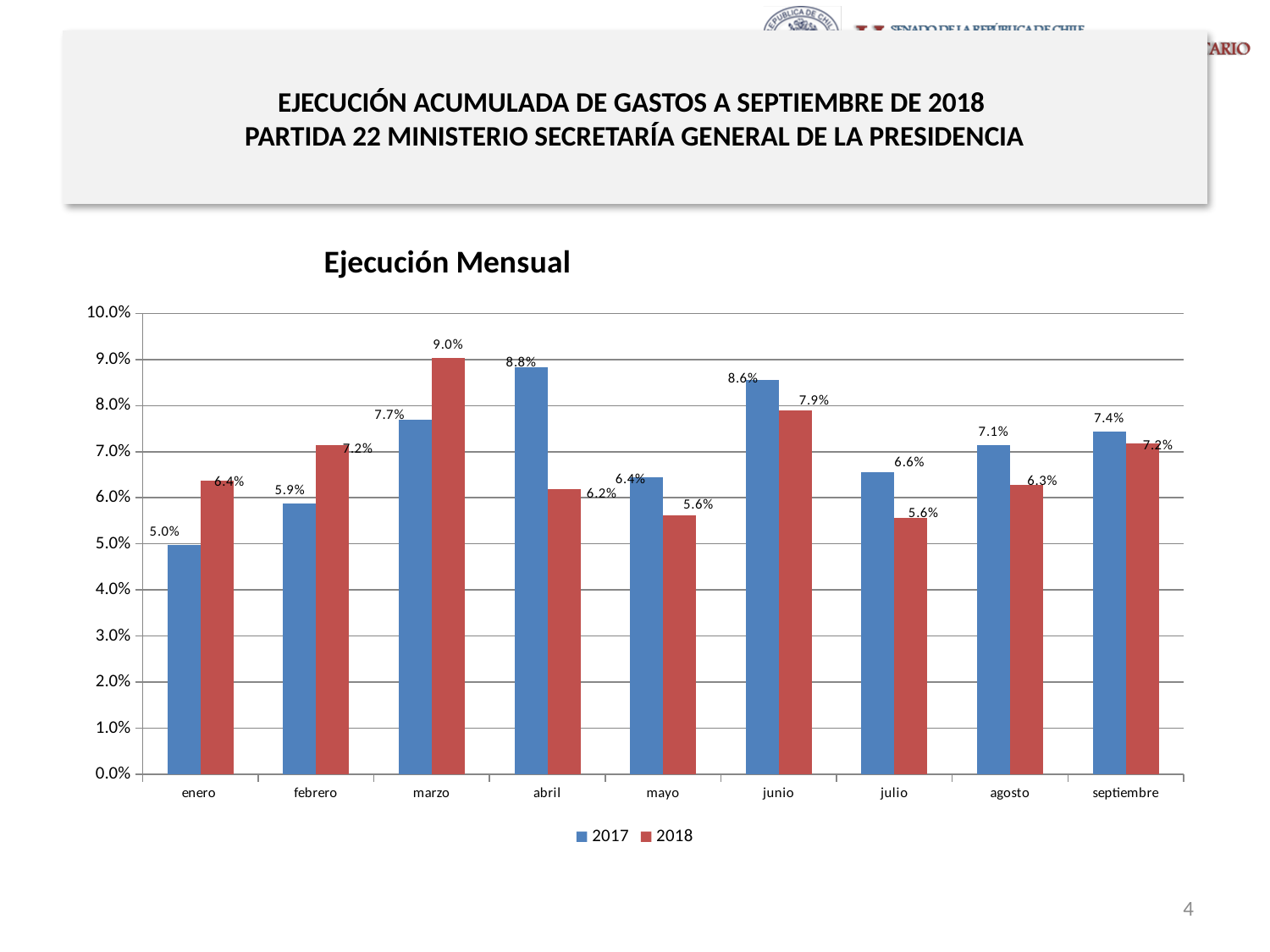
What is the value for 2017 in enero? 5.0% What kind of chart is shown? bar chart Which month has the highest value for the 2018 series? marzo Which month has the lowest value for the 2017 series? enero Which month has the highest value for the 2017 series? abril What is the title of the chart? Ejecución Mensual What is the difference between the 2018 and 2017 values in marzo? 1.3 percentage points What is the value for 2018 in marzo? 9.0% In junio, which series has the larger value, 2017 or 2018? 2017 How many series does the legend list? 2 What is the value for 2018 in agosto? 6.3% How many months are shown on the x axis? 9